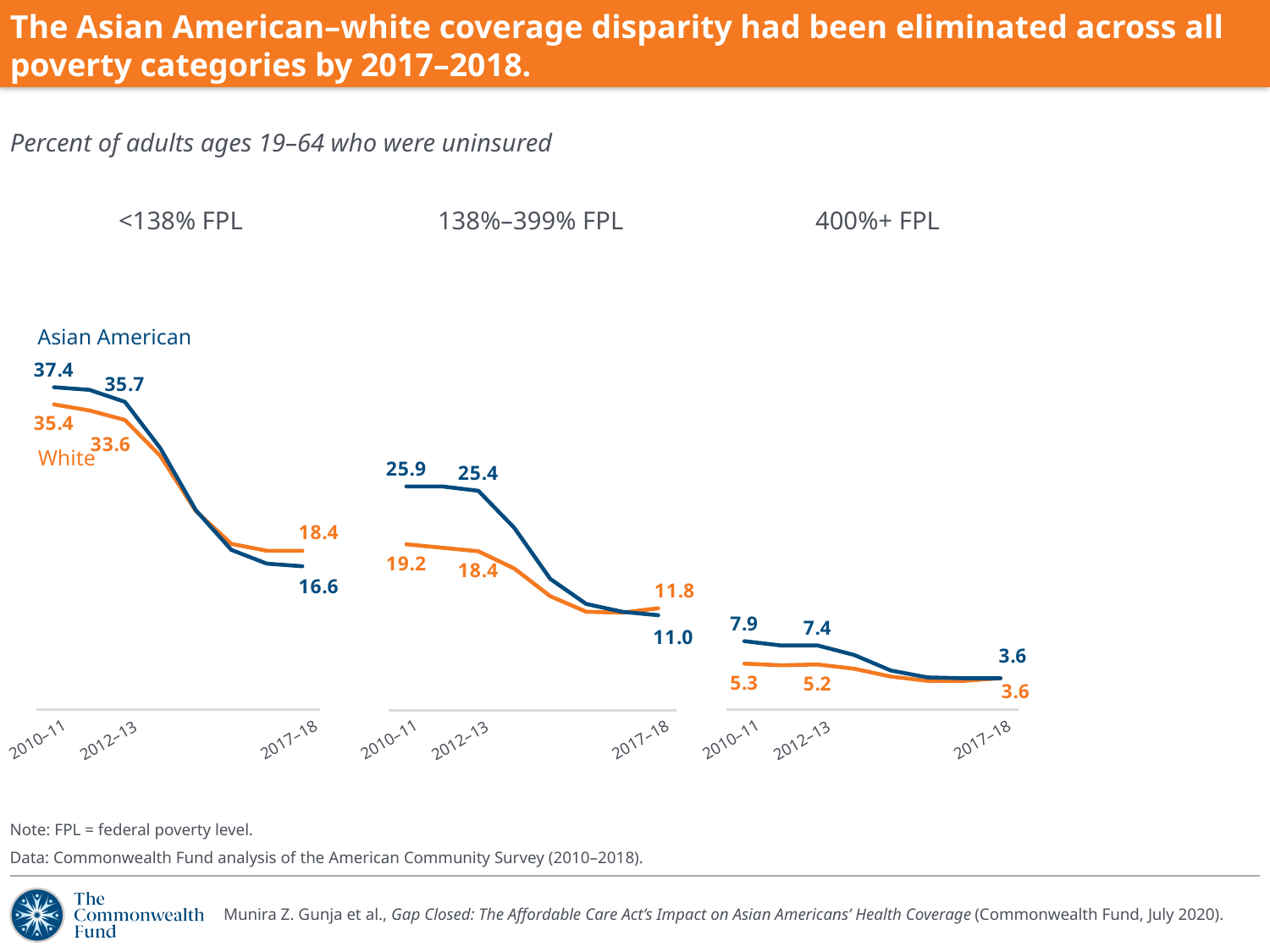
In the <138% FPL chart, what was the uninsured rate for white adults in 2017–18? 18.4 In the 400%+ FPL chart, what was the uninsured rate for Asian American adults in 2017–18? 3.6 In the 138%–399% FPL chart, what is the difference between the Asian American and white uninsured rates in 2010–11? 6.7 In the <138% FPL chart, does the Asian American uninsured rate rise or fall from 2010–11 to 2017–18? Fall In the 400%+ FPL chart, what was the uninsured rate for white adults in 2010–11? 5.3 In the 400%+ FPL chart, which group had the higher uninsured rate in 2012–13, Asian American or white? Asian American In the <138% FPL chart, what is the difference between the Asian American and white uninsured rates in 2010–11? 2.0 What kind of chart is used on this slide? Line chart In the 138%–399% FPL chart, which group had the higher uninsured rate in 2017–18, Asian American or white? White How many series are plotted in each chart? 2 In the <138% FPL chart, what was the uninsured rate for Asian American adults in 2010–11? 37.4 In the 138%–399% FPL chart, what was the uninsured rate for Asian American adults in 2012–13? 25.4